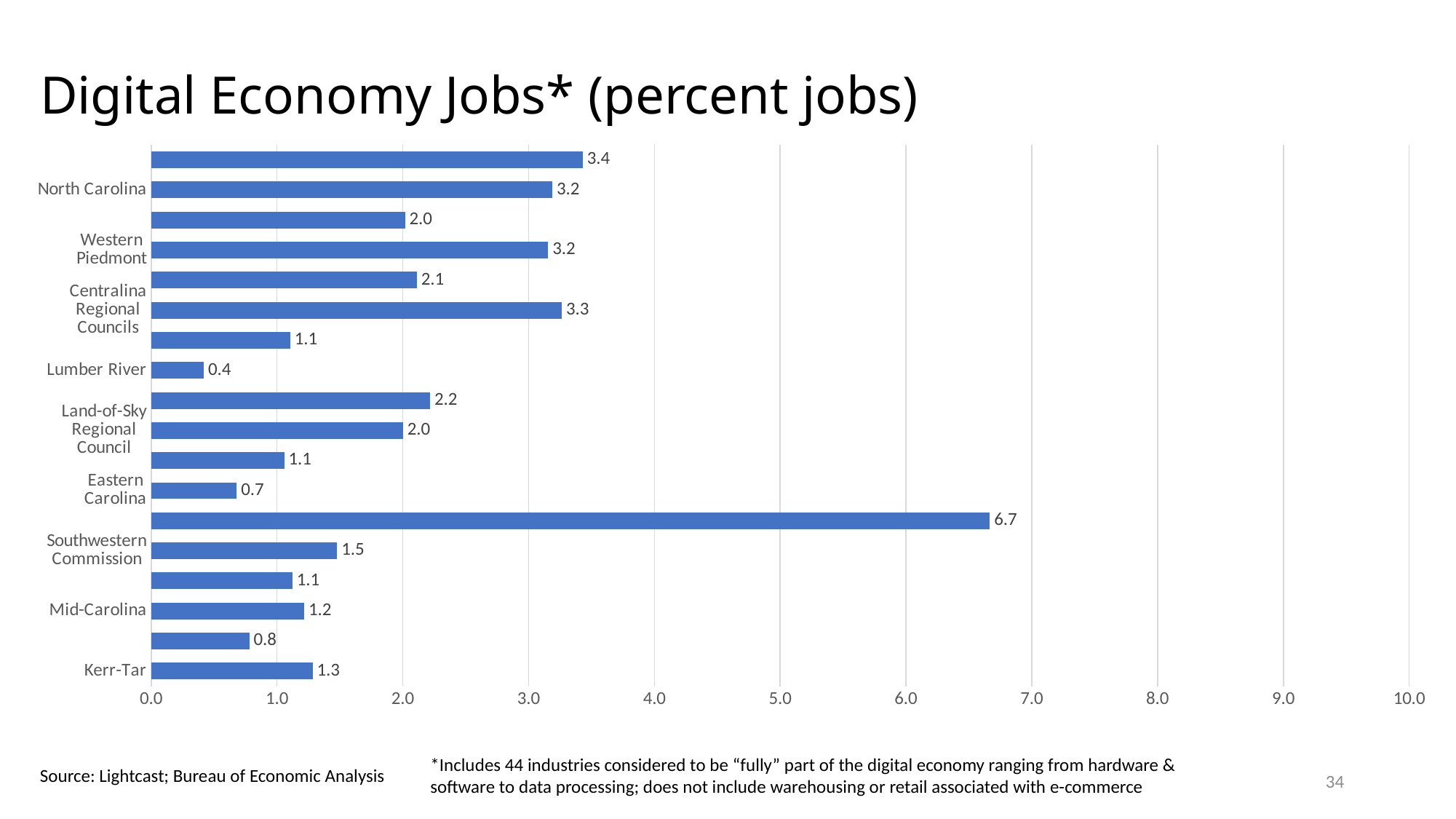
What is the value for North Carolina? 3.2 What is the value for Eastern Carolina? 0.7 Which has a larger value, Mid-Carolina or Kerr-Tar? Kerr-Tar What is the largest value labeled on any bar in the chart? 6.7 What kind of chart is shown on the slide? bar chart Is the value of the longest bar greater or less than 6.0? greater Which of the labeled categories has the lowest value? Lumber River How many bars are plotted in the chart? 18 What is the value for Lumber River? 0.4 What is the value for Southwestern Commission? 1.5 What is the value for Kerr-Tar? 1.3 What is the difference between the values for Centralina Regional Councils and Lumber River? 2.9